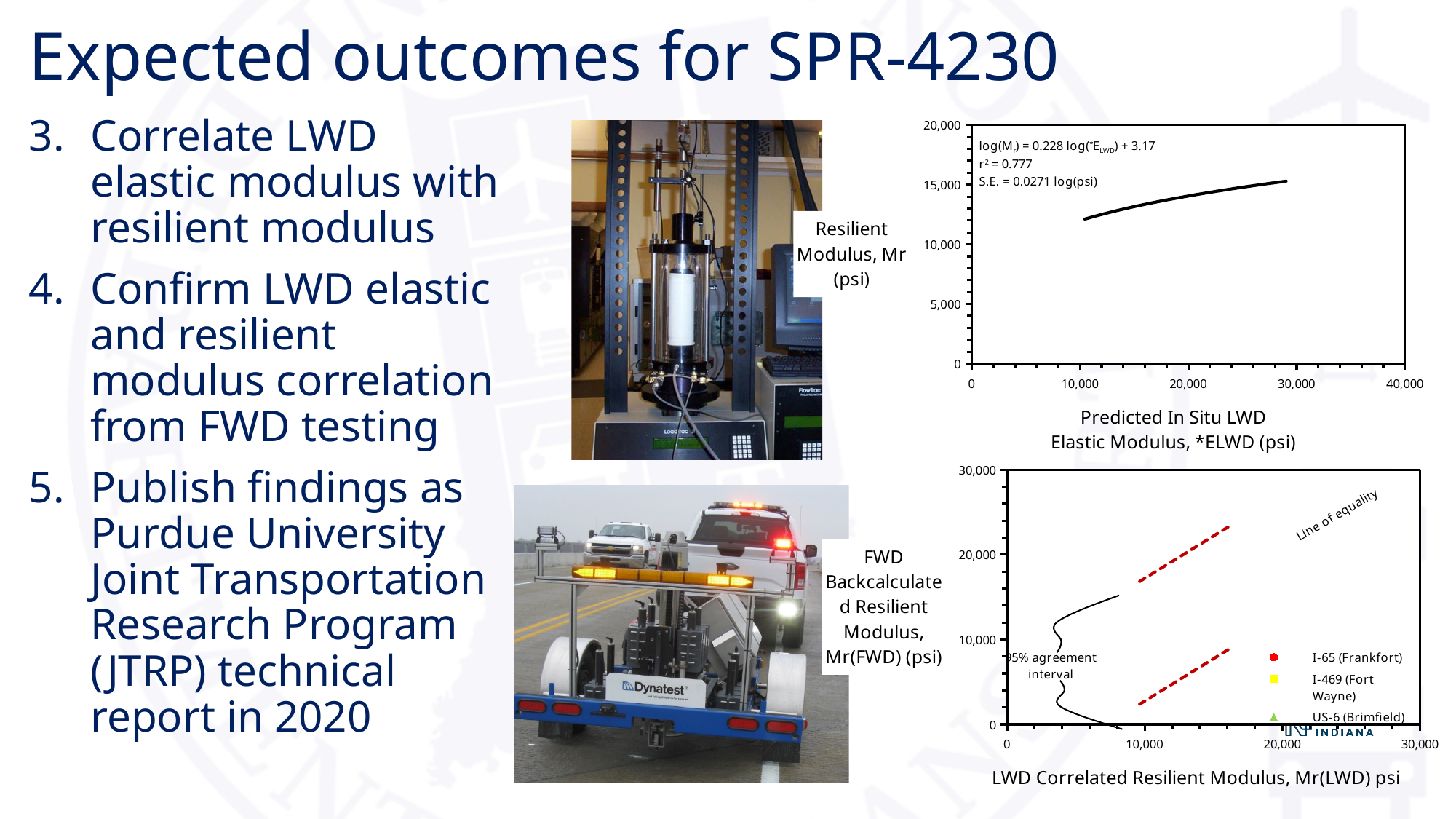
What r² value is printed on the top chart? r² = 0.777 In the top chart, is the Resilient Modulus at the left end of the curve (near 10,000 psi elastic modulus) greater or less than 10,000? greater What is the maximum value shown on the x axis of the top chart? 40,000 What is the maximum value shown on the y axis of the bottom chart? 30,000 What kind of chart is the top chart on the right, plotting Resilient Modulus against Predicted In Situ LWD Elastic Modulus? line chart In the top chart, does the Resilient Modulus rise or fall as the Predicted In Situ LWD Elastic Modulus increases? rise How many site entries does the legend of the bottom chart list? 3 In the top chart, is the Resilient Modulus at the right end of the curve (near 30,000 psi elastic modulus) greater or less than 20,000? less What standard error (S.E.) is printed on the top chart? 0.0271 log(psi)